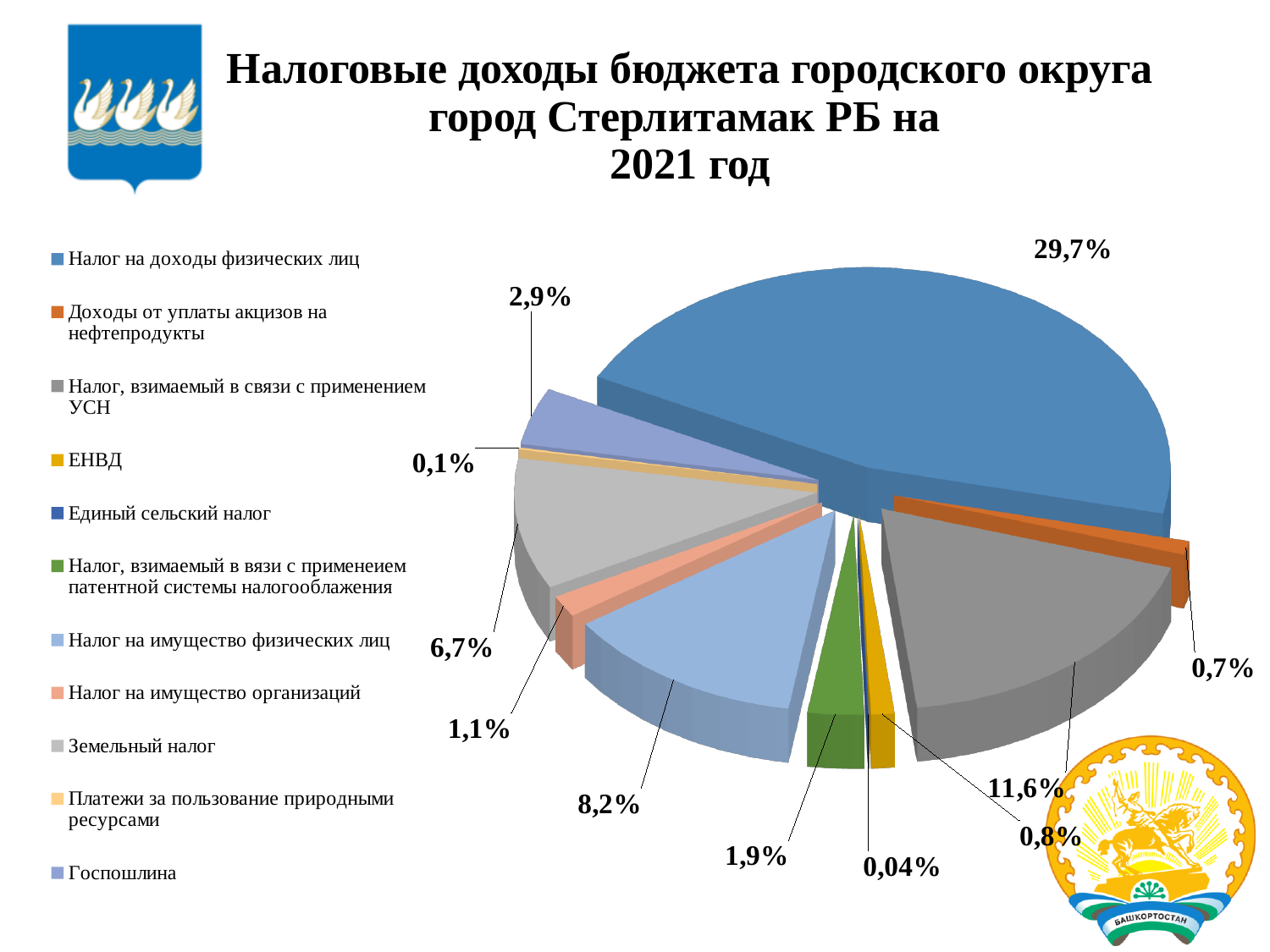
What is the value shown for Налог на имущество физических лиц? 8,2% What type of chart is shown on the slide? pie chart How many categories does the legend list? 11 Which category has the smallest value in the chart? Единый сельский налог What is the value shown for Налог на доходы физических лиц? 29,7% What is the difference between the values for Налог на доходы физических лиц and Налог, взимаемый в связи с применением УСН? 18,1% Which is larger: the value for Налог на имущество физических лиц or the value for Земельный налог? Налог на имущество физических лиц What is the value shown for Налог, взимаемый в связи с применением УСН? 11,6% What is the value shown for Земельный налог? 6,7% What is the value shown for Единый сельский налог? 0,04% What is the value shown for Госпошлина? 2,9% Which category has the largest value in the chart? Налог на доходы физических лиц